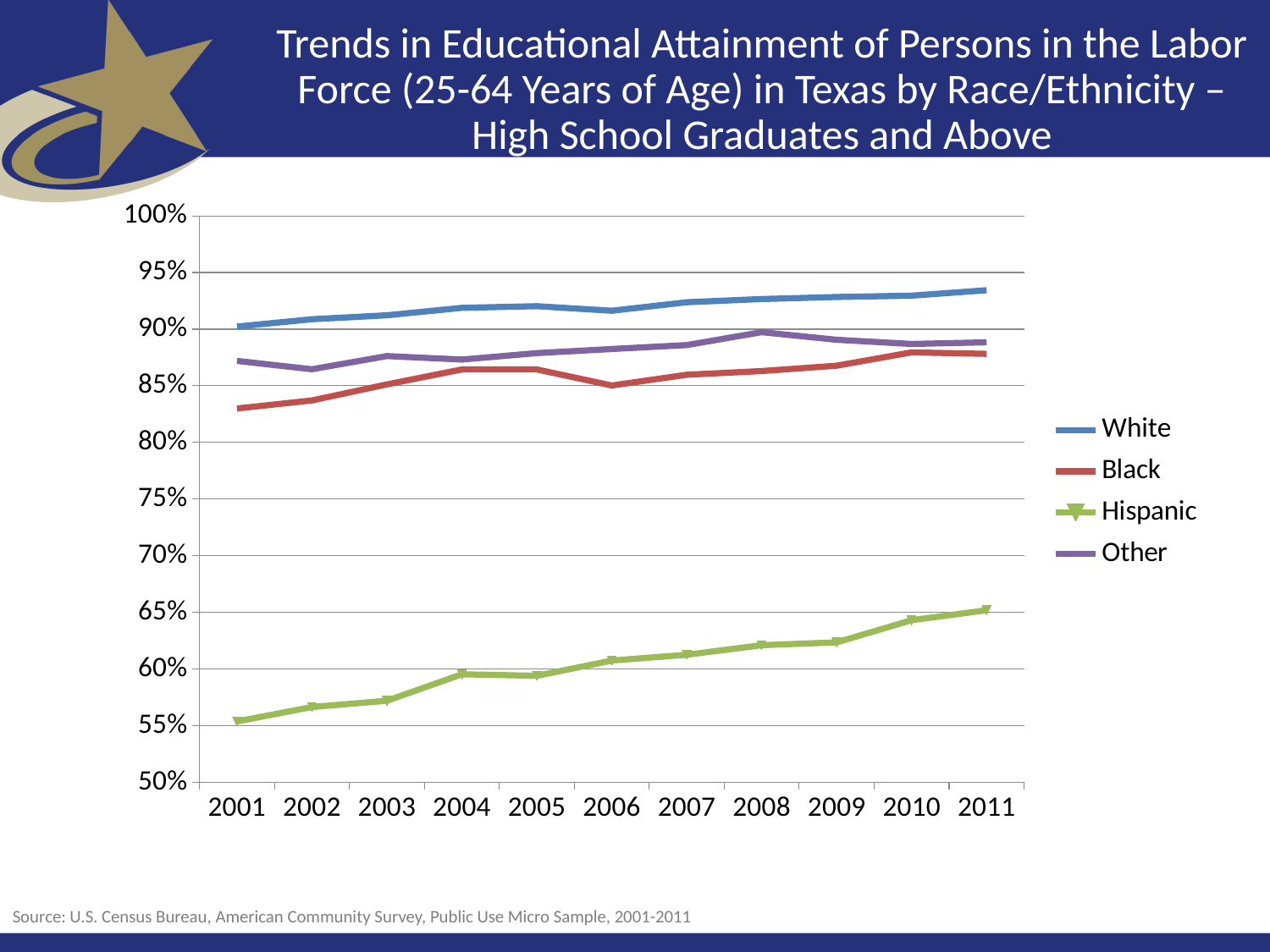
Is the value for Hispanic in 2001 greater or less than 60%? less Does the Hispanic series generally rise or fall from 2001 to 2011? rise Which series has the highest values across the chart? White How many years are shown along the x axis? 11 What kind of chart is shown on the slide? line chart How many series does the legend list? 4 Which series has the lowest values across the chart? Hispanic In 2006, which is larger, the value for Black or the value for Other? Other Is the value for Black in 2001 greater or less than 85%? less What colour is the line for the Hispanic series? green Is the value for White in 2011 greater or less than 90%? greater